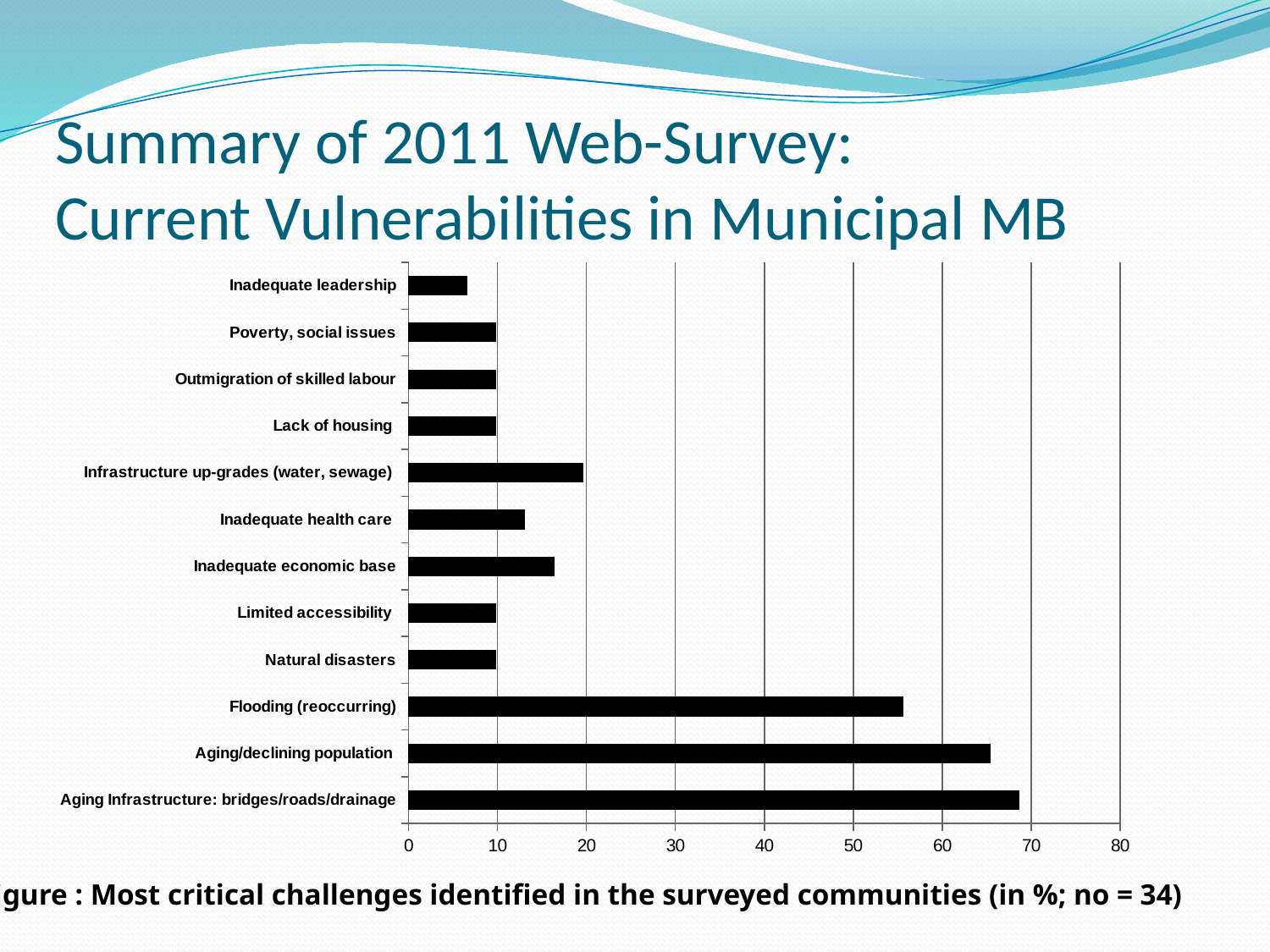
Is the value for Aging Infrastructure: bridges/roads/drainage greater or less than 70? less Which challenge has the lowest value in the chart? Inadequate leadership According to the figure caption, how many communities were surveyed (no = ?)? 34 Which challenge has the highest value in the chart? Aging Infrastructure: bridges/roads/drainage Which has a larger value: Flooding (reoccurring) or Aging/declining population? Aging/declining population How many categories (challenges) are plotted in the chart? 12 Which has a larger value: Infrastructure up-grades (water, sewage) or Inadequate economic base? Infrastructure up-grades (water, sewage) Is the value for Inadequate economic base greater or less than 10? greater Is the value for Inadequate leadership greater or less than 10? less What kind of chart is shown on the slide? bar chart